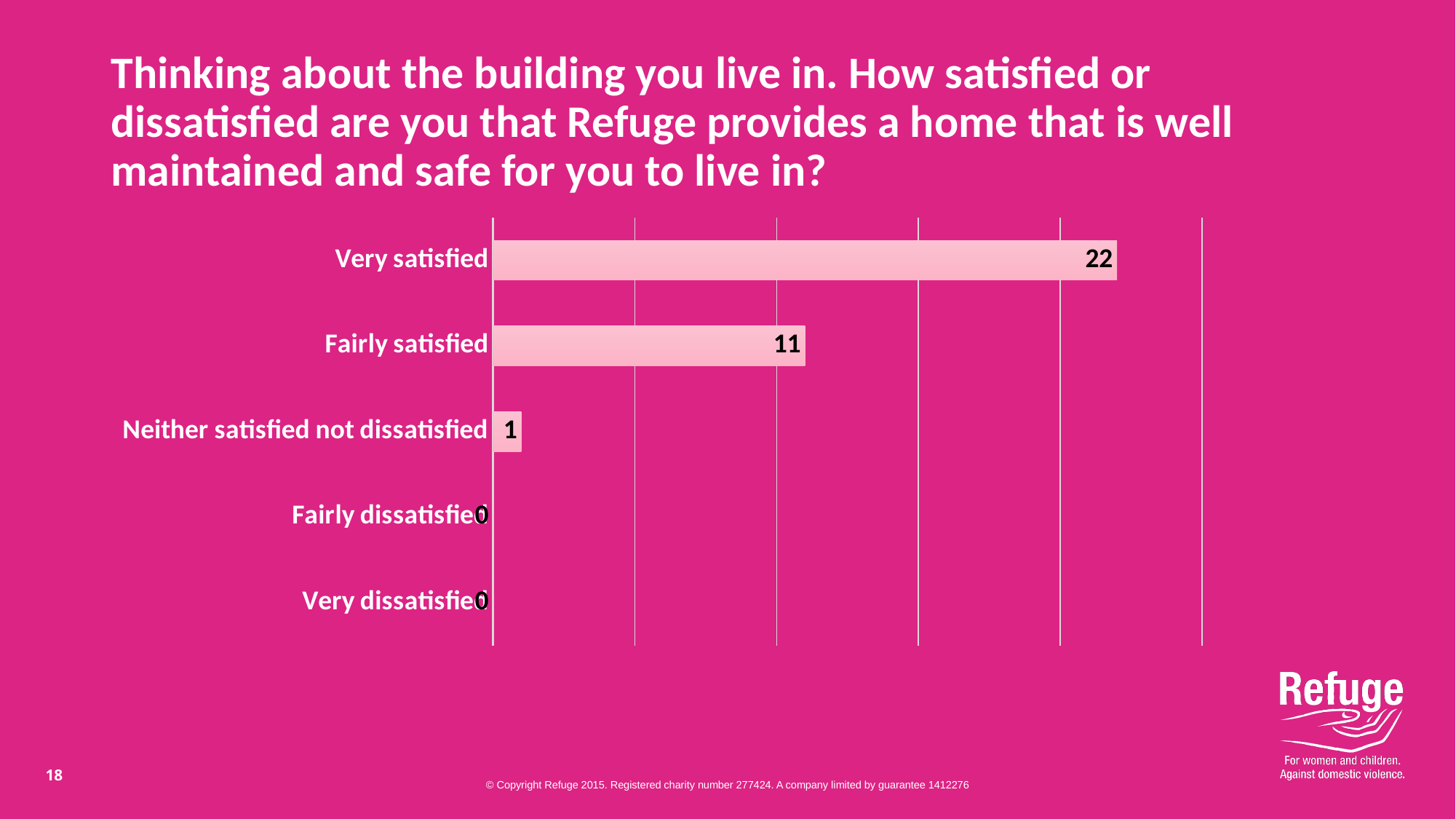
What kind of chart is shown on the slide? Bar chart Which is larger, the value for Fairly satisfied or the value for Neither satisfied not dissatisfied? Fairly satisfied What is the value for Neither satisfied not dissatisfied? 1 Which category has the highest value? Very satisfied How many categories are shown on the chart? 5 What is the difference between the values for Very satisfied and Fairly satisfied? 11 How many categories have a value of 0? 2 What is the value for Very dissatisfied? 0 What is the value for Fairly satisfied? 11 What is the value for Very satisfied? 22 What is the total of the values for Very satisfied, Fairly satisfied and Neither satisfied not dissatisfied? 34 What is the value for Fairly dissatisfied? 0